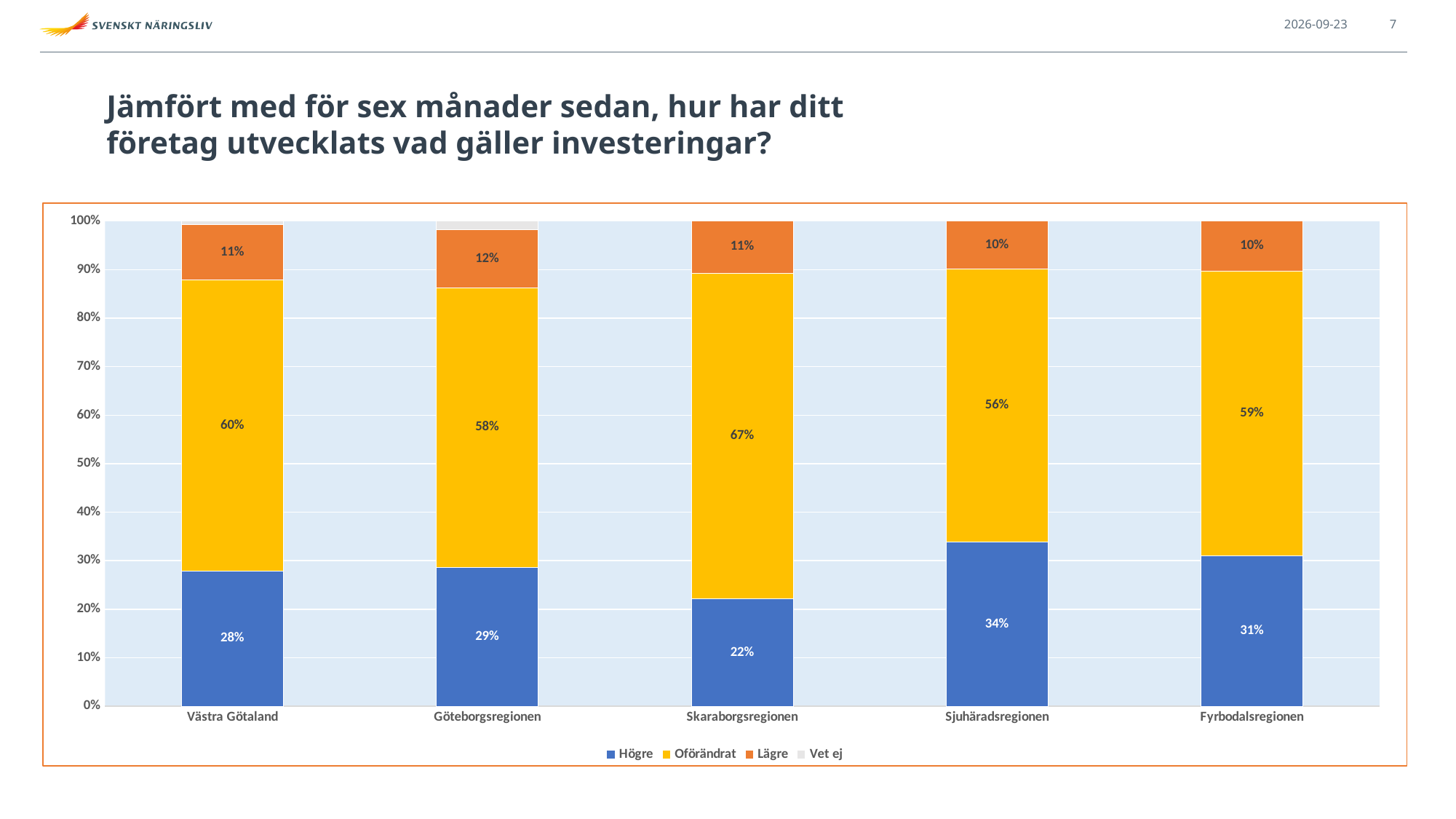
Which region has the lowest Högre share? Skaraborgsregionen Which region has the highest Oförändrat share? Skaraborgsregionen How many regions are shown on the x axis? 5 What kind of chart is shown on the slide? Stacked bar chart What is the Högre value for Sjuhäradsregionen? 34% Which region has the highest Högre share? Sjuhäradsregionen Which legend entry is shown in orange? Lägre What is the difference between the Högre values for Sjuhäradsregionen and Skaraborgsregionen? 12 percentage points What is the Lägre value for Göteborgsregionen? 12% How many series does the legend list? 4 What percentage of companies in Skaraborgsregionen answered Oförändrat? 67% Which is larger: the Oförändrat value for Västra Götaland or for Fyrbodalsregionen? Västra Götaland